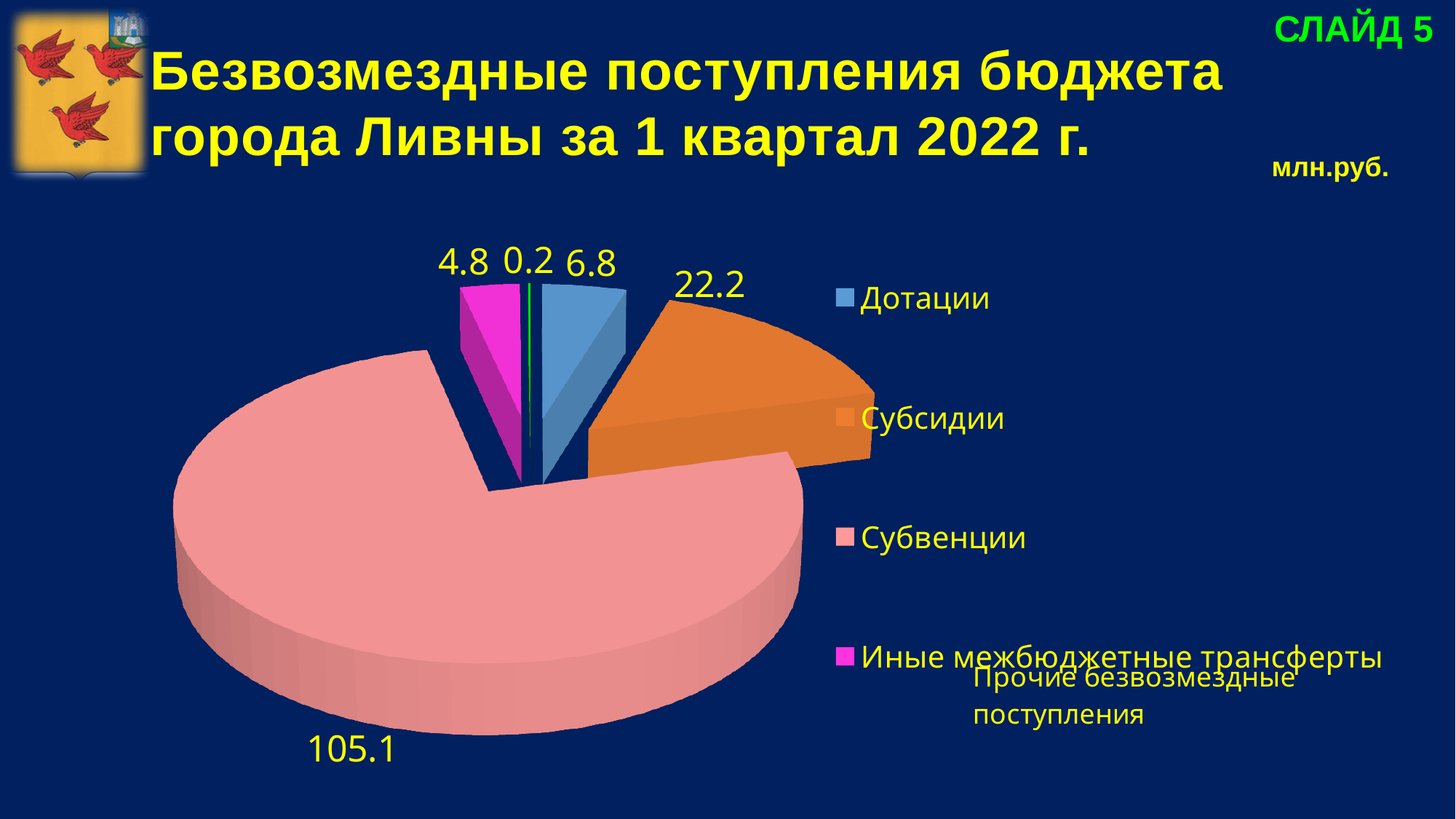
Which category has the smallest slice of the pie? Прочие безвозмездные поступления What type of chart is shown on the slide? Pie chart Which category has the largest slice of the pie? Субвенции What is the value for Субвенции? 105.1 What is the value for Дотации? 6.8 What is the value for Субсидии? 22.2 What is the value for Иные межбюджетные трансферты? 4.8 How many categories does the legend list? 5 What is the value for Прочие безвозмездные поступления? 0.2 What unit is stated for the values on the slide? млн.руб. Which is larger, the value for Дотации or the value for Иные межбюджетные трансферты? Дотации What is the difference between the values for Субвенции and Субсидии? 82.9